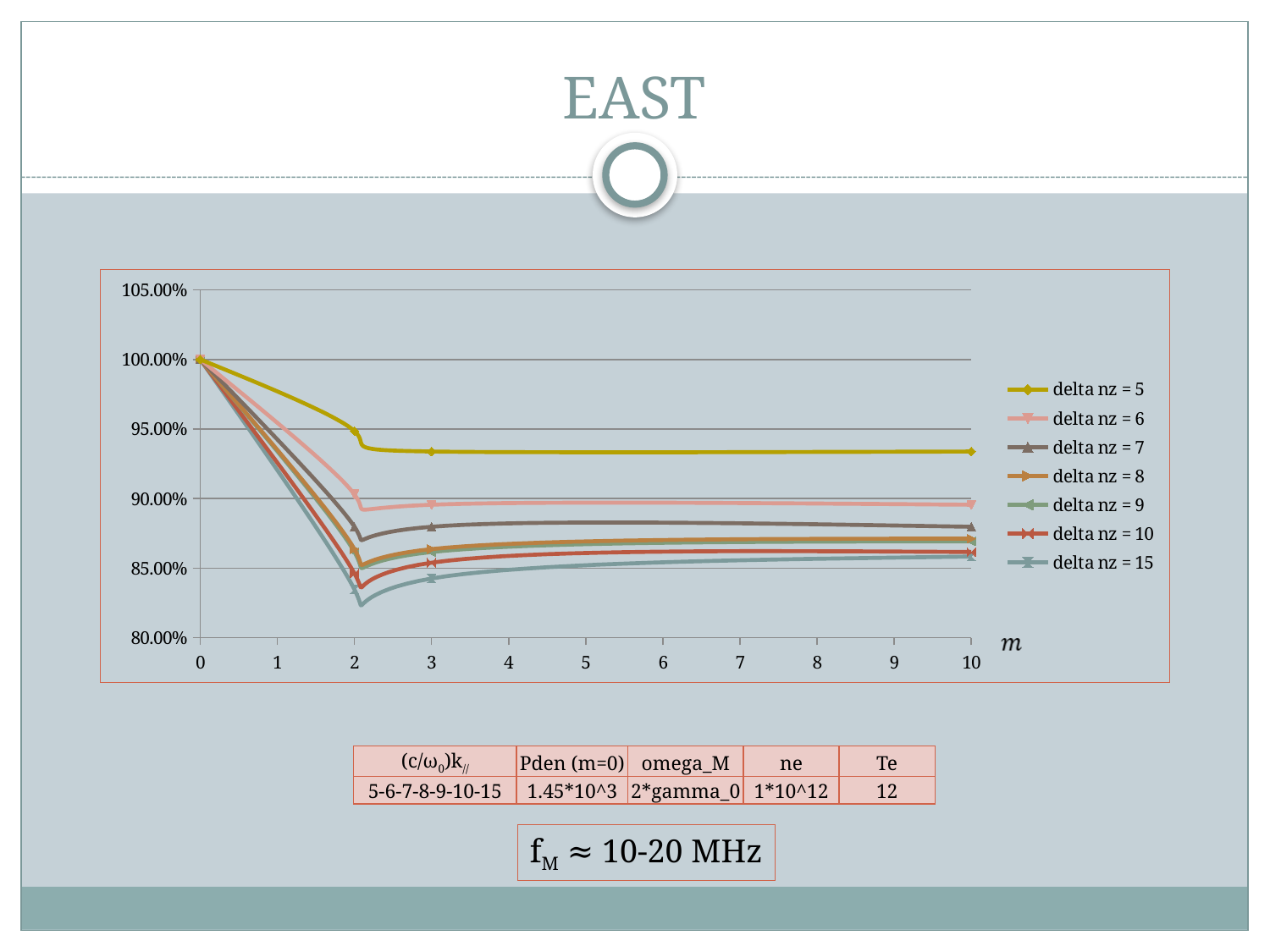
Is the value for delta nz = 7 at m = 10 greater or less than 85.00%? greater Is the value for delta nz = 15 at m = 2 greater or less than 85.00%? less Which series has the lowest value at m = 10? delta nz = 15 What is the label on the x axis? m What is the value of every series at m = 0? 100.00% What type of chart is shown on the slide? line chart What is the highest value shown on the y axis? 105.00% Do the values rise or fall between m = 0 and m = 2? fall Is the value for delta nz = 5 at m = 10 greater or less than 90.00%? greater Which series has the highest value at m = 10? delta nz = 5 How many series does the legend list? 7 At m = 3, which is larger: delta nz = 6 or delta nz = 7? delta nz = 6